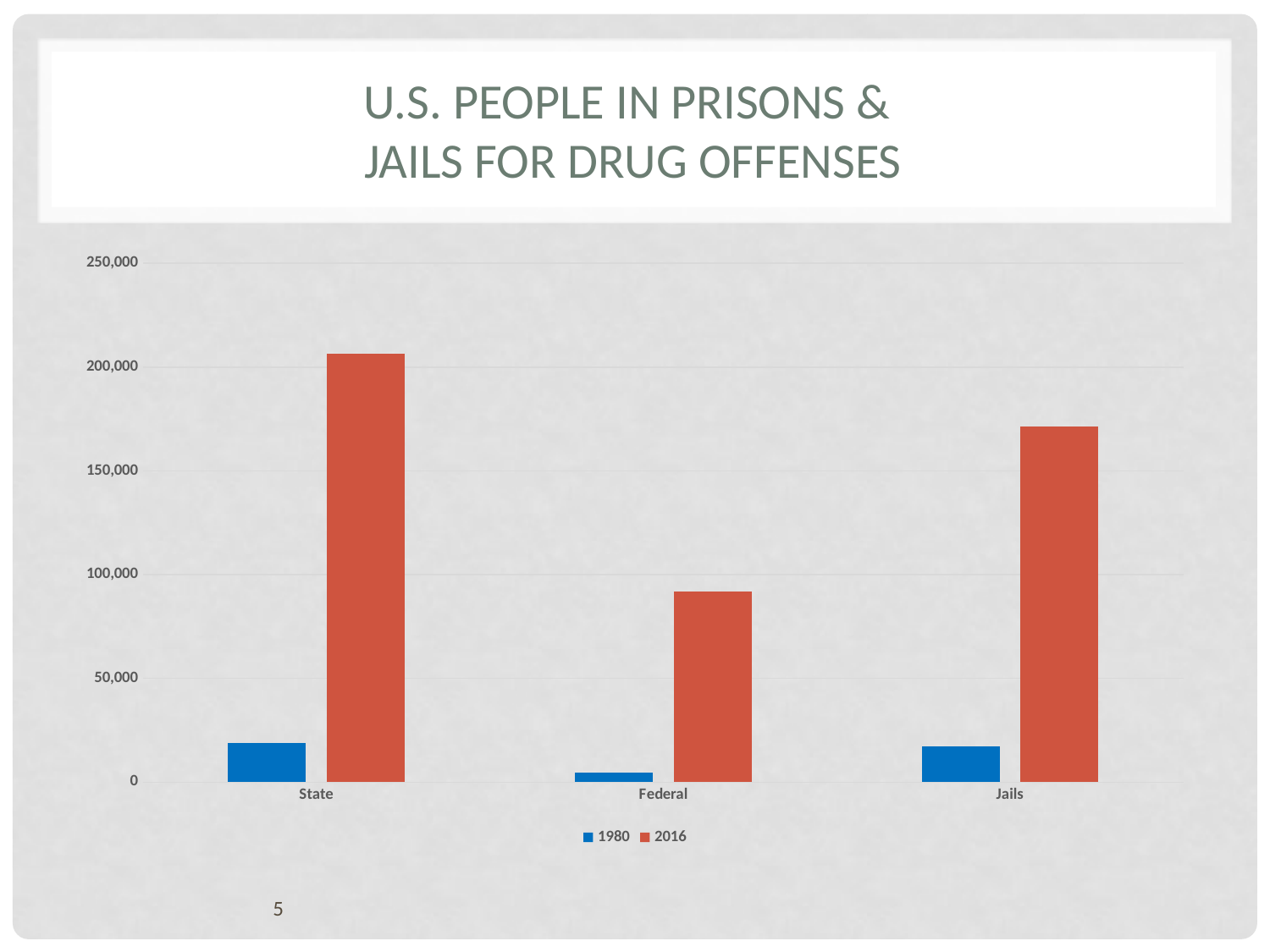
Which category has the lowest value for 2016? Federal Is the 2016 value for State greater or less than 200,000? greater Which category has the highest value for 2016? State What kind of chart is shown on the slide? bar chart Which category has the lowest value for 1980? Federal How many series does the legend list? 2 For Jails, which series has the larger value, 1980 or 2016? 2016 What is the title of the chart on the slide? U.S. PEOPLE IN PRISONS & JAILS FOR DRUG OFFENSES Is the 1980 value for State greater or less than 50,000? less How many categories are shown on the x axis? 3 Is the 2016 value for Federal greater or less than 100,000? less